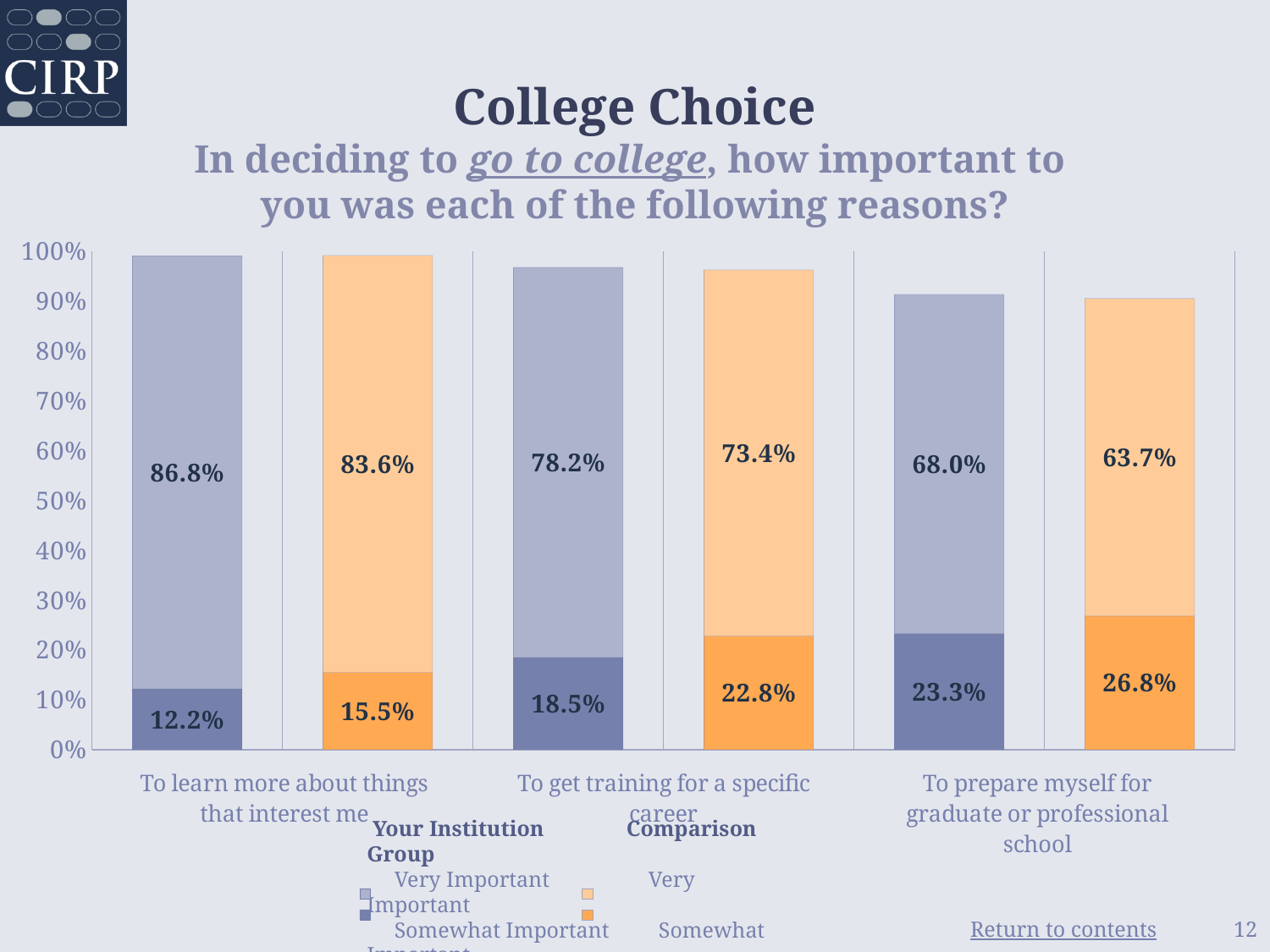
Which reason has the highest Very Important percentage for Your Institution? To learn more about things that interest me What percentage of the Comparison Group rated 'To prepare myself for graduate or professional school' as Somewhat Important? 26.8% What is the total of the stacked bar for the Comparison Group on 'To prepare myself for graduate or professional school'? 90.5% What is the total of the stacked bar for Your Institution on 'To learn more about things that interest me'? 99.0% What is the Comparison Group's Very Important value for 'To get training for a specific career'? 73.4% How many series does the legend list? 4 Which reason has the lowest Very Important percentage for the Comparison Group? To prepare myself for graduate or professional school What percentage of Your Institution respondents rated 'To learn more about things that interest me' as Very Important? 86.8% What is the difference between Your Institution's and the Comparison Group's Very Important values for 'To get training for a specific career'? 4.8% For 'To prepare myself for graduate or professional school', which is larger: Your Institution's Somewhat Important value or the Comparison Group's Somewhat Important value? Comparison Group What kind of chart is shown on the slide? Stacked bar chart How many reasons (categories) are shown on the x axis? 3